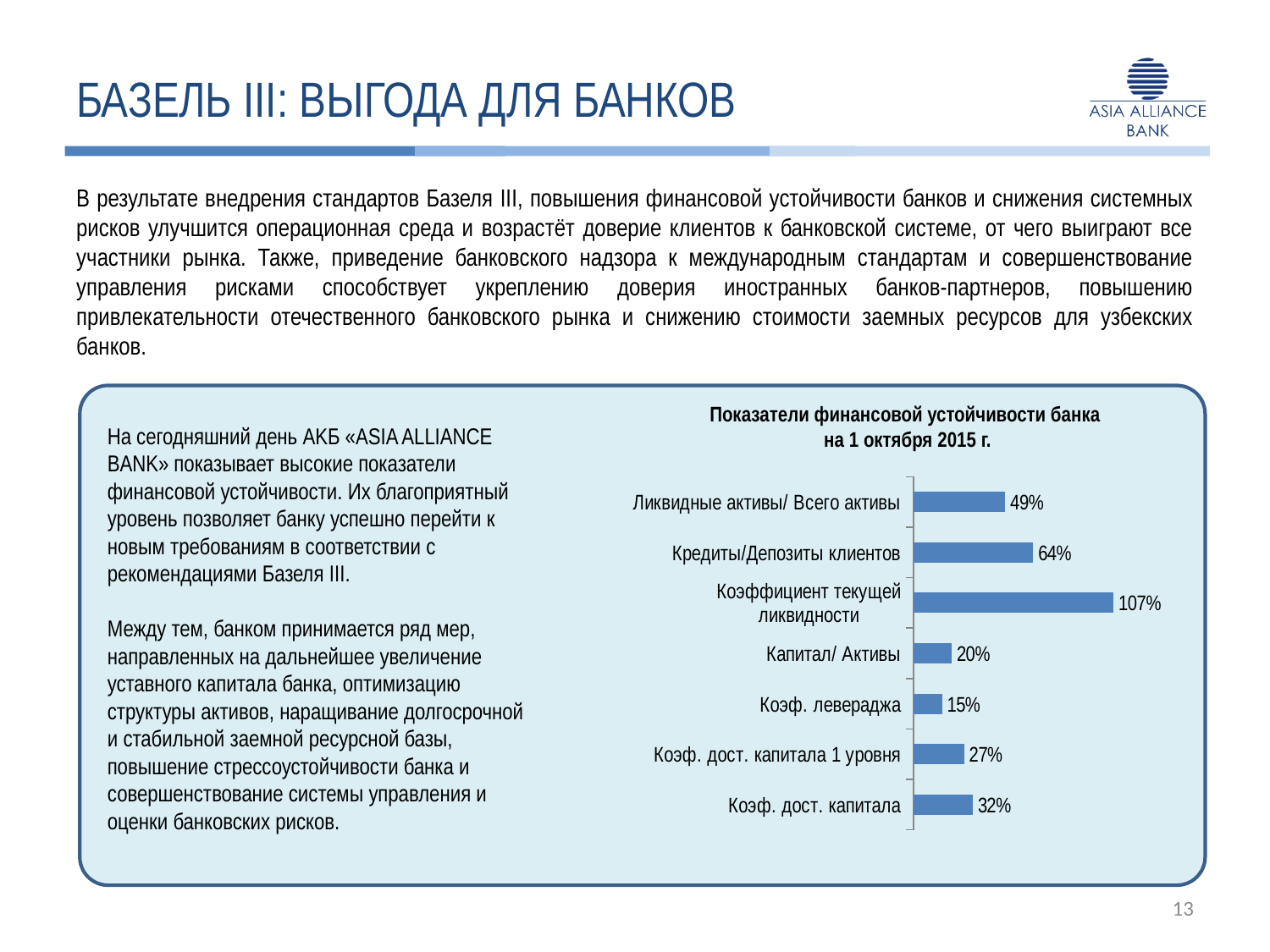
What is the difference between Кредиты/Депозиты клиентов and Ликвидные активы/ Всего активы? 15% What is the title of the chart? Показатели финансовой устойчивости банка на 1 октября 2015 г. What is the value for Коэф. леверaджа? 15% What is the value for Кредиты/Депозиты клиентов? 64% What is the value for Ликвидные активы/ Всего активы? 49% Which category has the lowest value? Коэф. леверaджа Which is larger: Коэф. дост. капитала or Капитал/ Активы? Коэф. дост. капитала What kind of chart is shown on the slide? Bar chart What is the value for Коэф. дост. капитала 1 уровня? 27% Which category has the highest value? Коэффициент текущей ликвидности How many categories are shown in the chart? 7 What is the value for Коэффициент текущей ликвидности? 107%